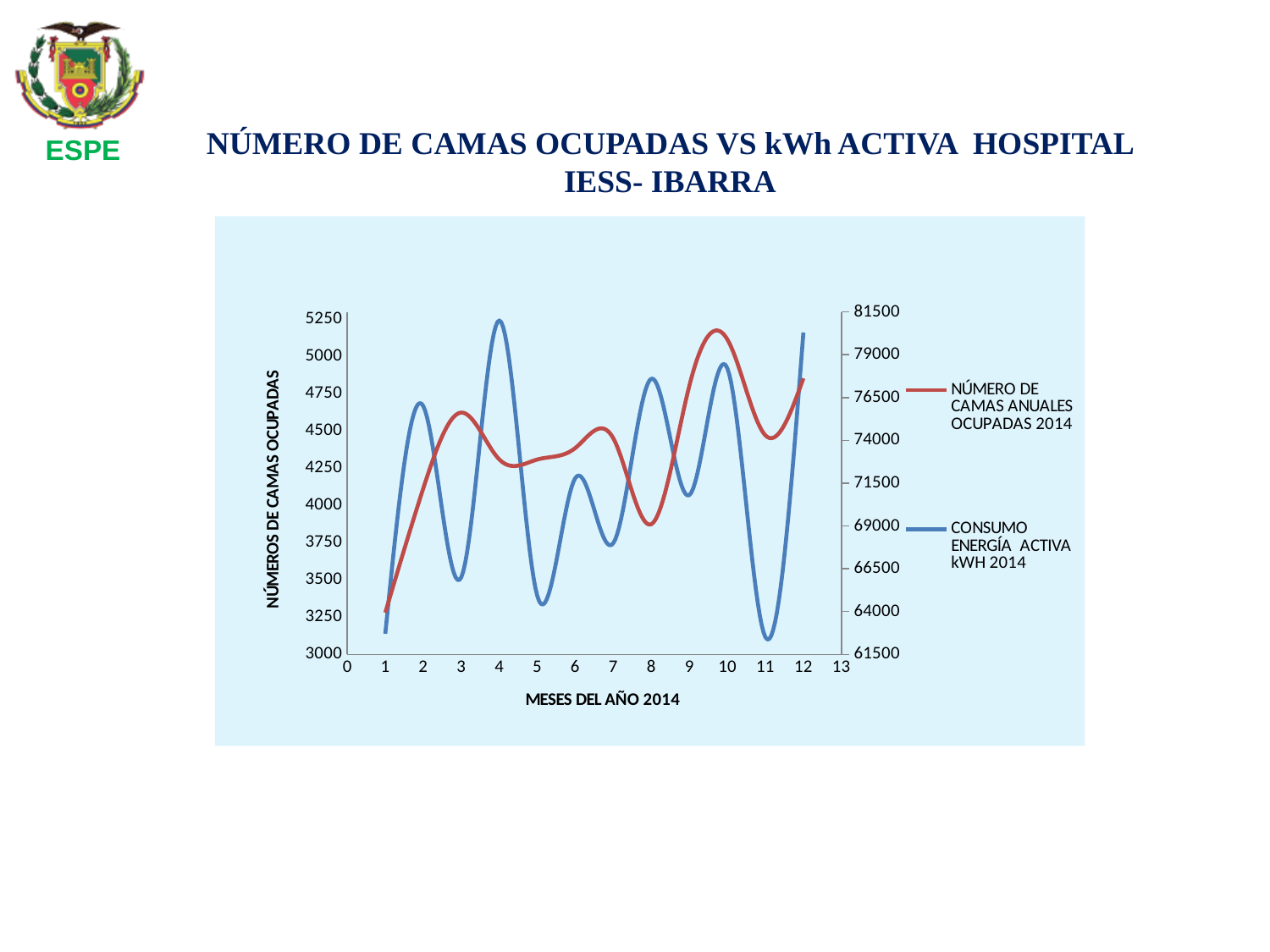
How many months are plotted along the x axis? 12 In which month does the NÚMERO DE CAMAS ANUALES OCUPADAS 2014 series reach its highest value? 10 Which series is drawn in blue? CONSUMO ENERGÍA ACTIVA kWH 2014 Is the value for NÚMERO DE CAMAS ANUALES OCUPADAS 2014 in month 10 greater or less than 5000? greater Is the value for NÚMERO DE CAMAS ANUALES OCUPADAS 2014 in month 1 greater or less than 3500? less In which month does the NÚMERO DE CAMAS ANUALES OCUPADAS 2014 series have its lowest value? 1 What kind of chart is shown on the slide? line chart Is the value for CONSUMO ENERGÍA ACTIVA kWH 2014 in month 11 greater or less than 64000? less What is the title of the chart? NÚMERO DE CAMAS OCUPADAS VS kWh ACTIVA HOSPITAL IESS- IBARRA Does the NÚMERO DE CAMAS ANUALES OCUPADAS 2014 series rise or fall from month 1 to month 3? rise How many series does the legend list? 2